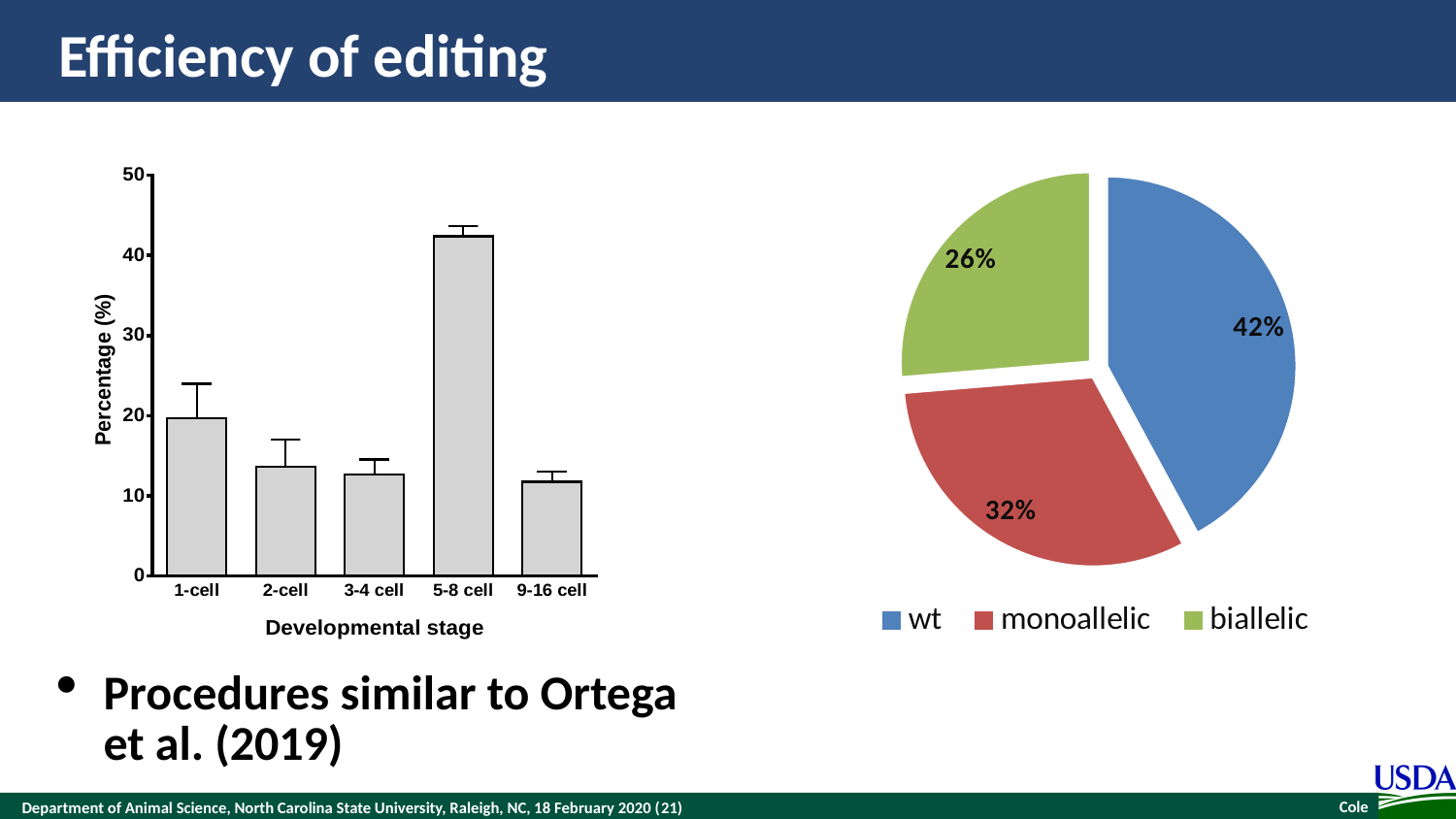
In the bar chart on the left, which developmental stage has the highest percentage? 5-8 cell In the pie chart on the right, what percentage is labelled for the wt slice? 42% In the bar chart on the left, is the value for 2-cell greater or less than 20? less In the pie chart on the right, what percentage is labelled for the biallelic slice? 26% In the pie chart on the right, which category has the smallest slice? biallelic In the pie chart on the right, how many categories does the legend list? 3 In the pie chart on the right, what percentage is labelled for the monoallelic slice? 32% In the pie chart on the right, how many percentage points larger is the wt slice than the monoallelic slice? 10 percentage points In the pie chart on the right, which category has the largest slice? wt In the bar chart on the left, is the value for 5-8 cell greater or less than 40? greater In the bar chart on the left, how many developmental stages are shown on the x axis? 5 In the bar chart on the left, which is larger, the value for 1-cell or the value for 2-cell? 1-cell